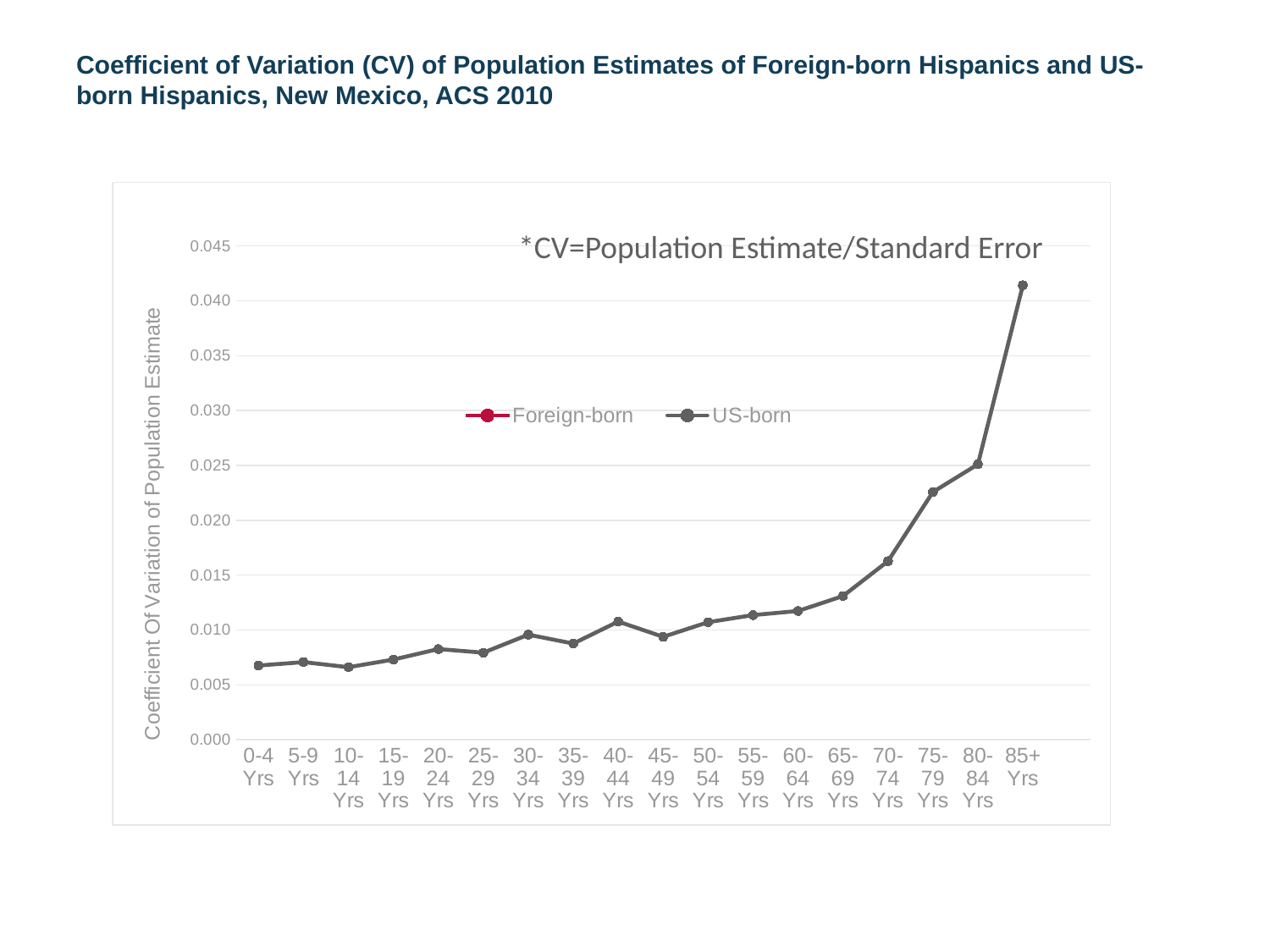
Is the US-born value for 75-79 Yrs greater or less than 0.020? greater Is the US-born value for 70-74 Yrs greater or less than 0.020? less Is the US-born value for 85+ Yrs greater or less than 0.035? greater Do the US-born values generally rise or fall as age increases along the x axis? rise Which is larger for the US-born series, the value for 85+ Yrs or the value for 0-4 Yrs? 85+ Yrs How many series does the legend list? 2 How many age-group categories are shown on the x axis? 18 Which age group has the highest coefficient of variation for the US-born series? 85+ Yrs What kind of chart is shown on the slide? line chart What is the label of the y axis? Coefficient Of Variation of Population Estimate